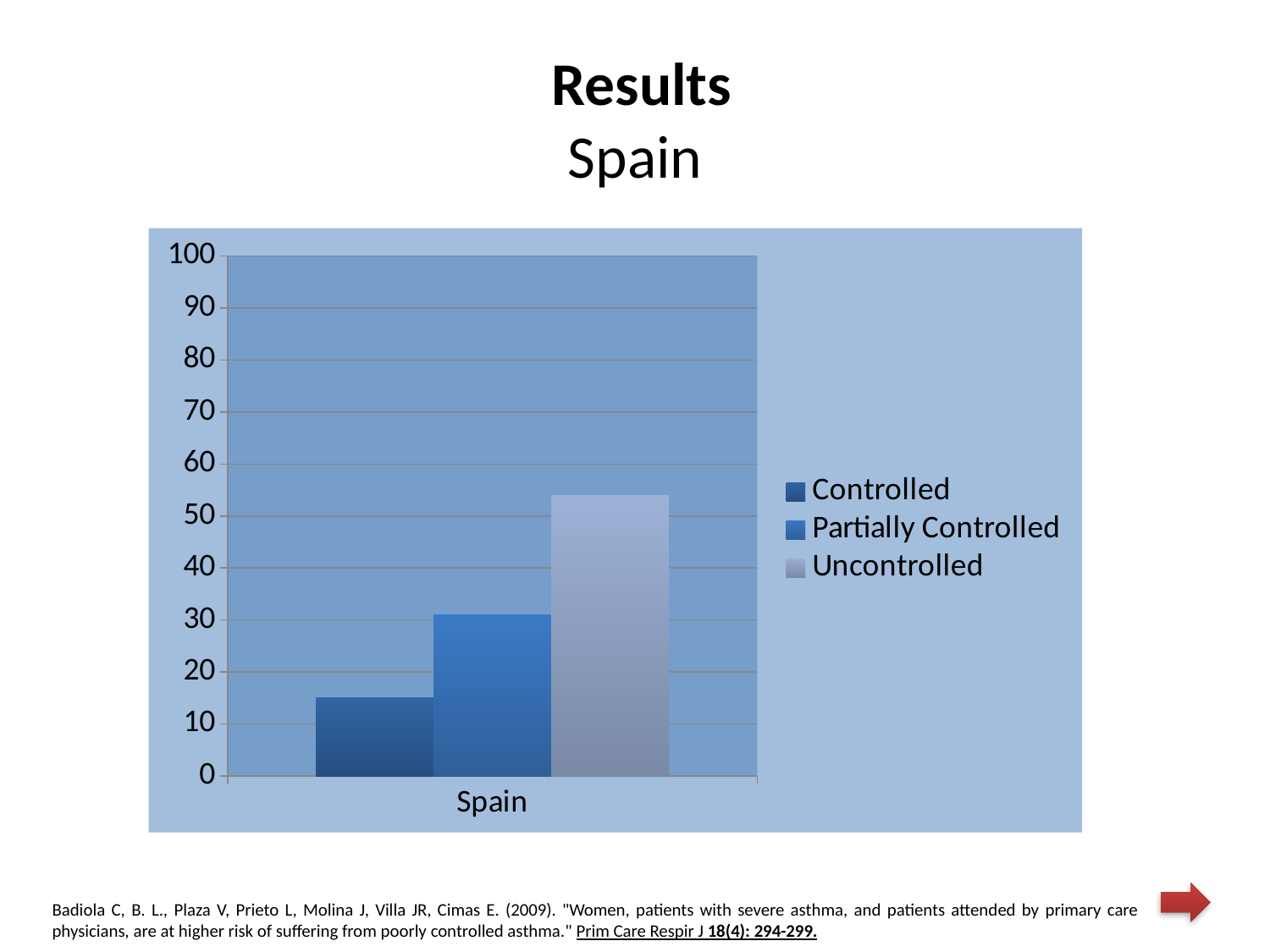
How many categories are shown on the x axis? 1 Is the value for Partially Controlled greater or less than 40? less Is the value for Uncontrolled greater or less than 50? greater What is the category label shown on the x axis? Spain Which is larger for Spain, Partially Controlled or Controlled? Partially Controlled Is the value for Controlled greater or less than 20? less Which is larger for Spain, Uncontrolled or Partially Controlled? Uncontrolled What kind of chart is shown on the slide? bar chart Which series has the lowest value for Spain? Controlled Which series has the highest value for Spain? Uncontrolled How many series does the legend list? 3